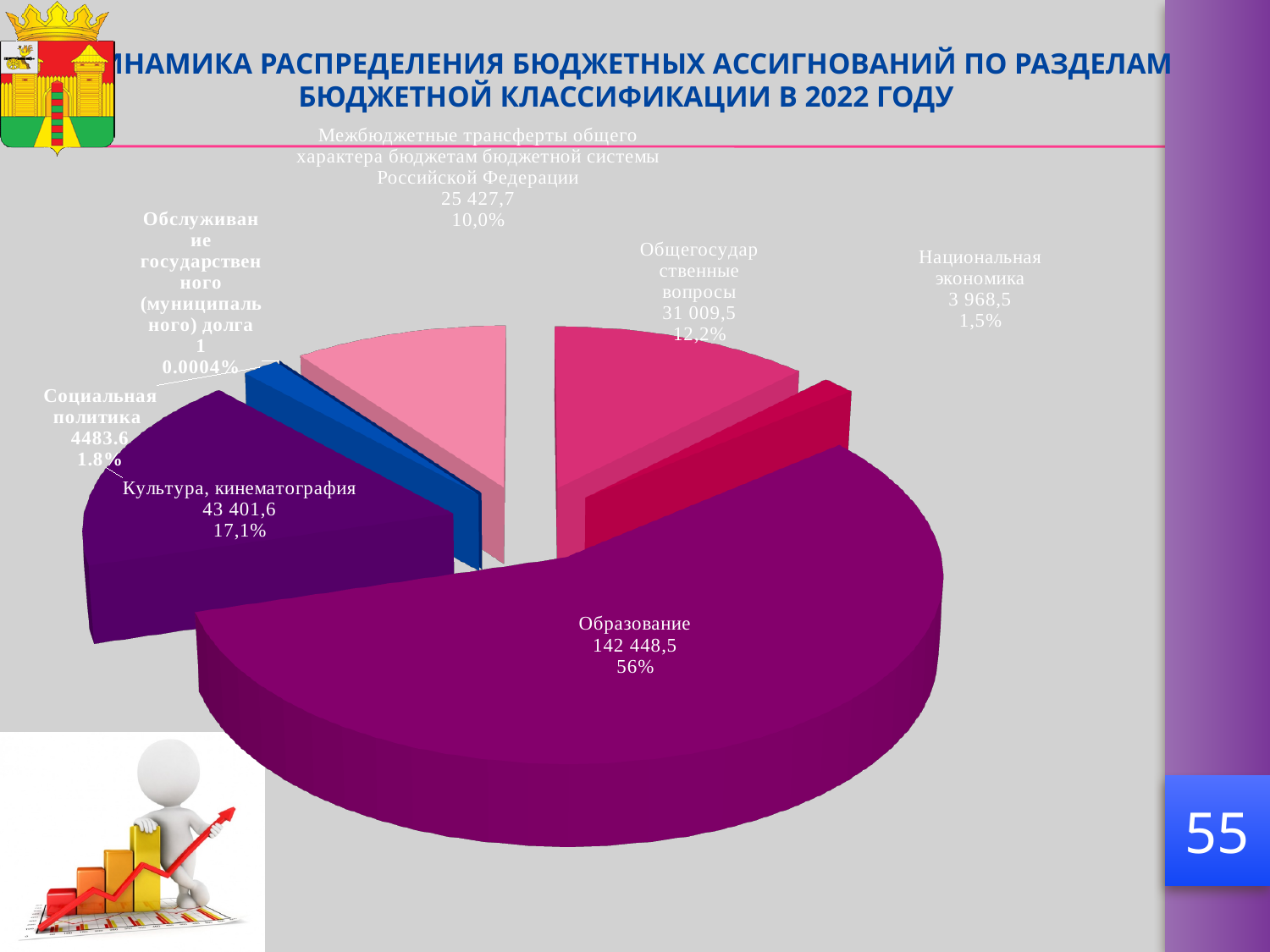
What is the value for Национальная экономика? 3 968,5 How many categories are shown in the pie chart? 7 What is the value for Культура, кинематография? 43 401,6 Which category has the smallest slice of the pie? Обслуживание государственного (муниципального) долга What percentage is shown for Межбюджетные трансферты общего характера бюджетам бюджетной системы Российской Федерации? 10,0% What is the difference between the values for Образование and Культура, кинематография? 99 046,9 What is the value for Образование? 142 448,5 What share of the pie does Образование take? 56% What percentage is shown for Общегосударственные вопросы? 12,2% What kind of chart is shown on the slide? pie chart Which category has the largest slice of the pie? Образование Which is larger, the value for Общегосударственные вопросы or the value for Социальная политика? Общегосударственные вопросы